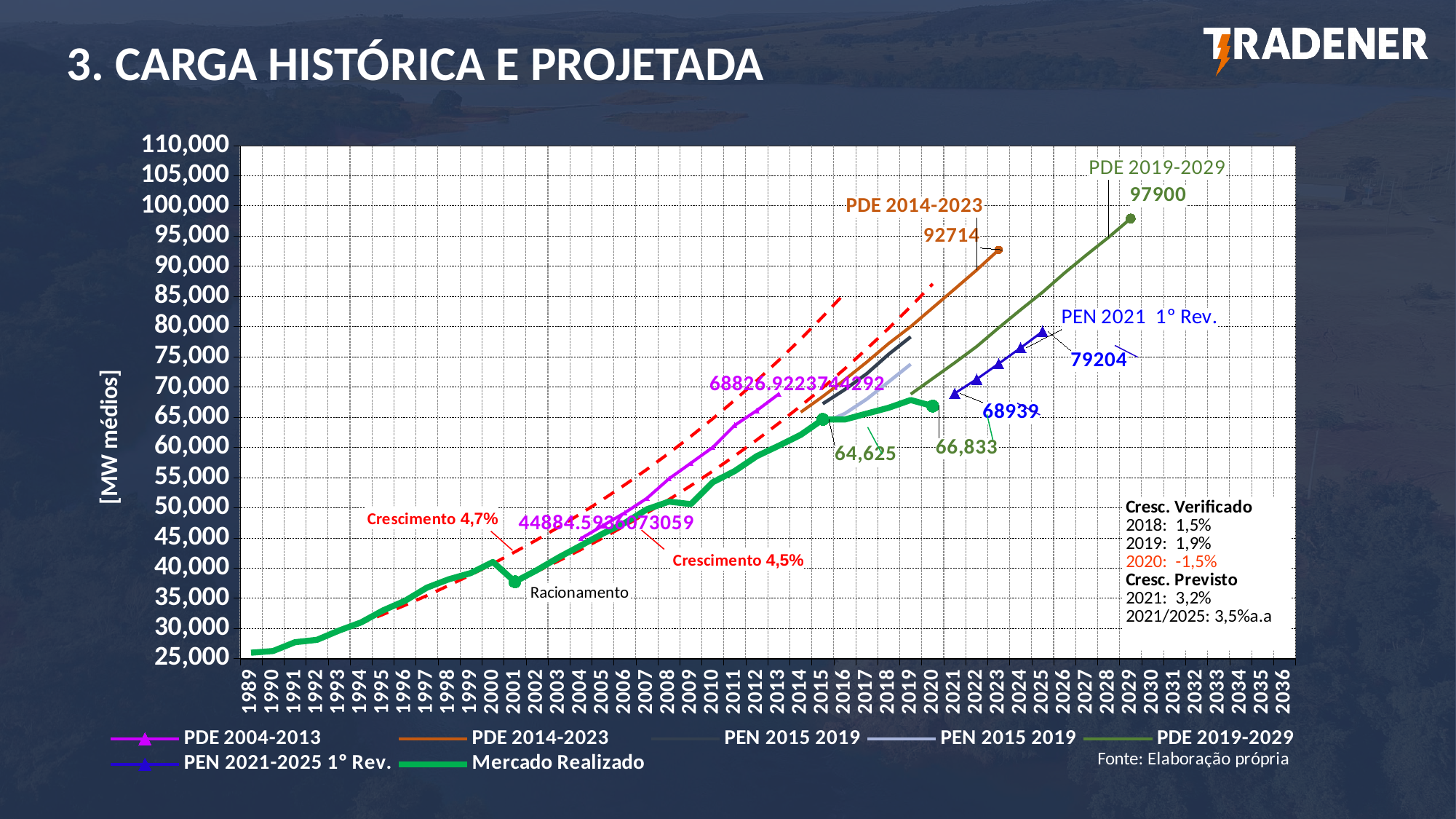
By how much does the PEN 2021-2025 1° Rev. series grow from its 2021 value (68939) to its 2025 value (79204)? 10265 How many series does the legend list? 7 Which is larger for Mercado Realizado: the 2015 value or the 2020 value? 2020 (66,833) What is the final value of the PDE 2014-2023 series in 2023? 92714 What is the difference between the 2029 value of PDE 2019-2029 (97900) and the 2023 value of PDE 2014-2023 (92714)? 5186 What is the label on the y axis? [MW médios] What value does the PDE 2019-2029 series reach in 2029? 97900 What kind of chart is shown on the slide? line chart What value does the PEN 2021-2025 1° Rev. series show for 2025? 79204 Is the Mercado Realizado value in 2001 (the Racionamento point) greater or less than 40,000? less What is the Mercado Realizado value labelled for 2020? 66,833 What is the Mercado Realizado value labelled for 2015? 64,625